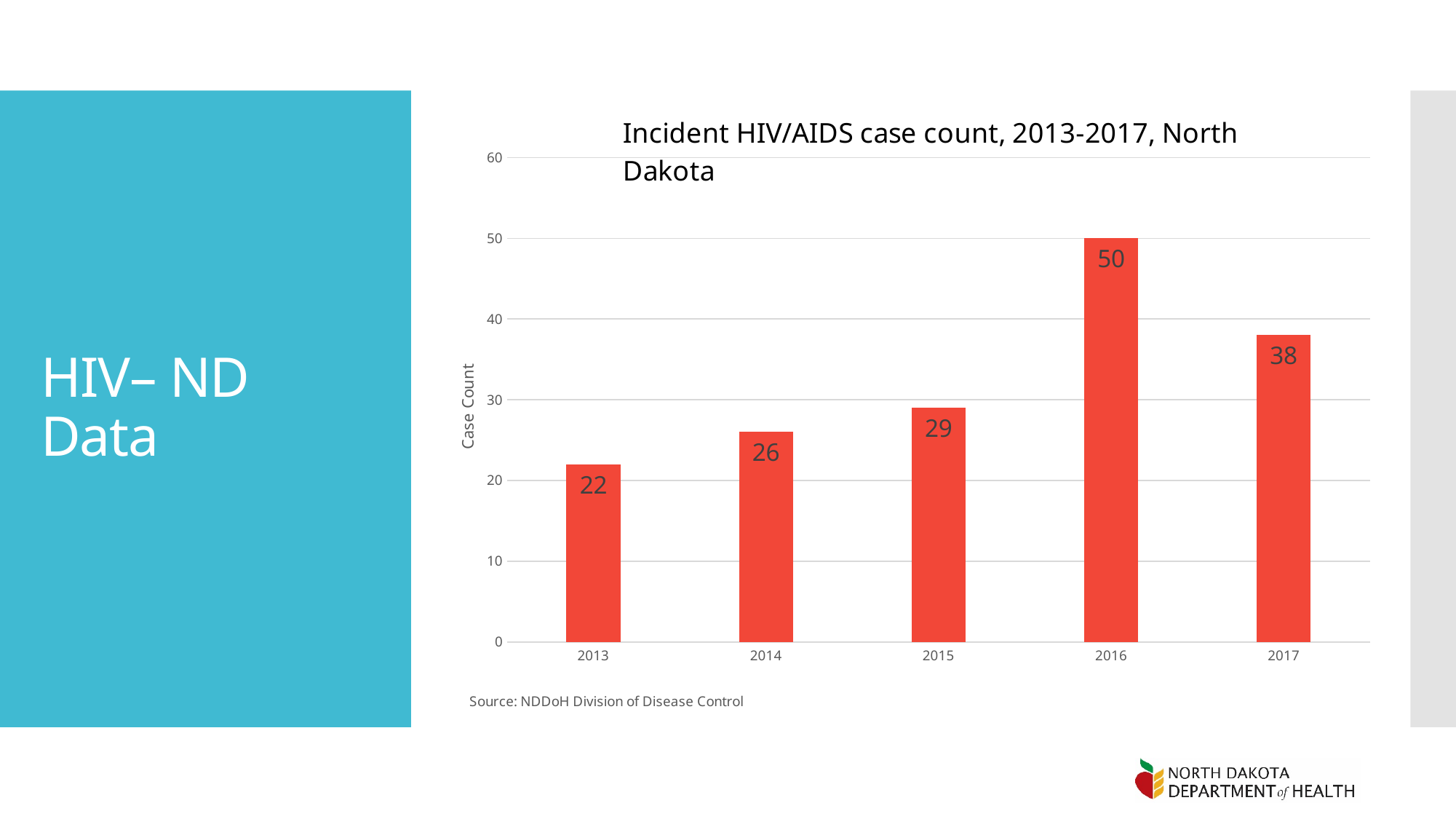
How many years are shown on the x axis? 5 Which year has the lowest case count? 2013 What kind of chart is shown on the slide? bar chart What is the case count for 2013? 22 Which year has the highest case count? 2016 What is the title of the chart? Incident HIV/AIDS case count, 2013-2017, North Dakota What is the difference in case count between 2015 and 2014? 3 What is the difference in case count between 2016 and 2017? 12 What is the case count for 2016? 50 What is the case count for 2017? 38 Is the case count for 2015 greater or less than 30? less Which year has a larger case count, 2014 or 2017? 2017